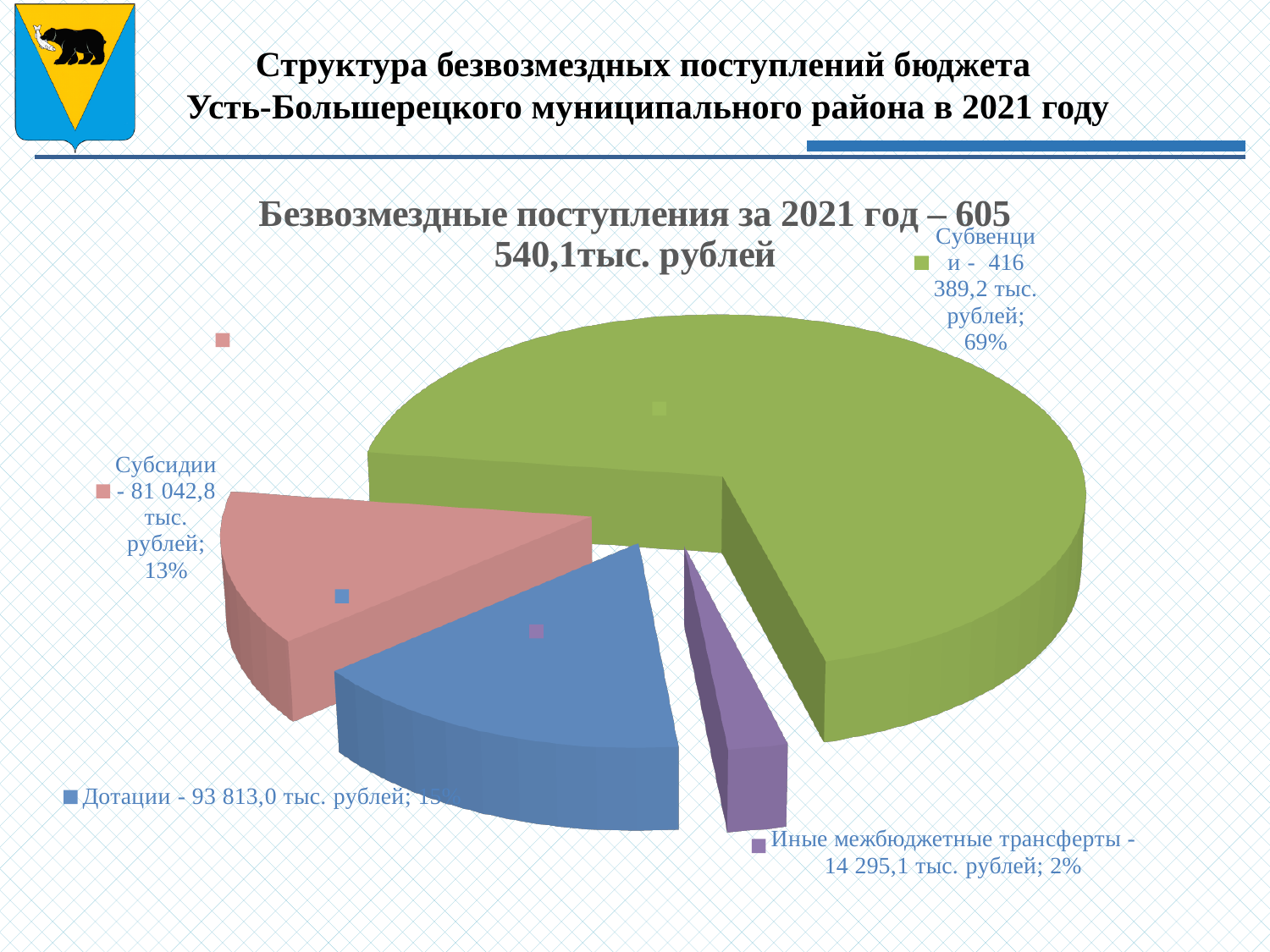
What share of the pie does Субвенции represent? 69% What is the difference between the values for Дотации and Субсидии? 12 770,2 тыс. рублей What is the value shown for Субвенции? 416 389,2 тыс. рублей How many slices does the pie chart have? 4 What share of the pie does Субсидии represent? 13% Which category has the largest slice of the pie? Субвенции What kind of chart is shown on the slide? Pie chart What is the value shown for Иные межбюджетные трансферты? 14 295,1 тыс. рублей Which category has the smallest slice of the pie? Иные межбюджетные трансферты What is the value shown for Дотации? 93 813,0 тыс. рублей What is the value shown for Субсидии? 81 042,8 тыс. рублей What share of the pie does Иные межбюджетные трансферты represent? 2%